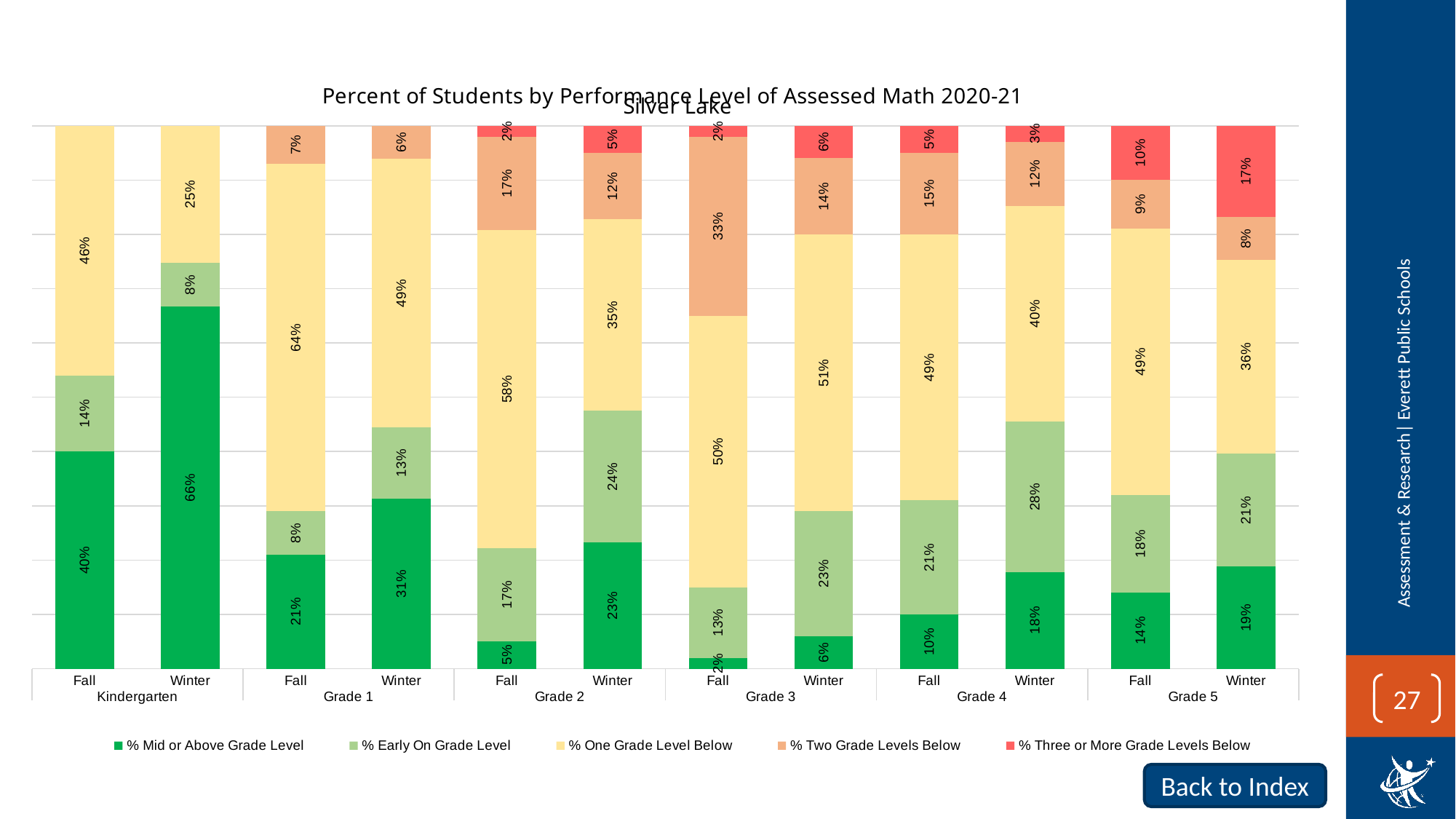
Which school is named in the chart's subtitle? Silver Lake What is the % Two Grade Levels Below value for Grade 3 Fall? 33% Which is larger, the % Early On Grade Level value for Grade 4 Winter or for Grade 2 Winter? Grade 4 Winter What is the % Mid or Above Grade Level value for Kindergarten Winter? 66% How many series does the legend list? 5 What is the % Three or More Grade Levels Below value for Grade 5 Winter? 17% What kind of chart is shown on the slide? Stacked bar chart How many bars are plotted in the chart? 12 Which bar has the lowest % Mid or Above Grade Level value? Grade 3 Fall Which bar has the highest % Mid or Above Grade Level value? Kindergarten Winter What is the difference between the % One Grade Level Below values for Grade 1 Fall and Grade 1 Winter? 15% Does the % Mid or Above Grade Level value rise or fall from Fall to Winter for Grade 2? Rise